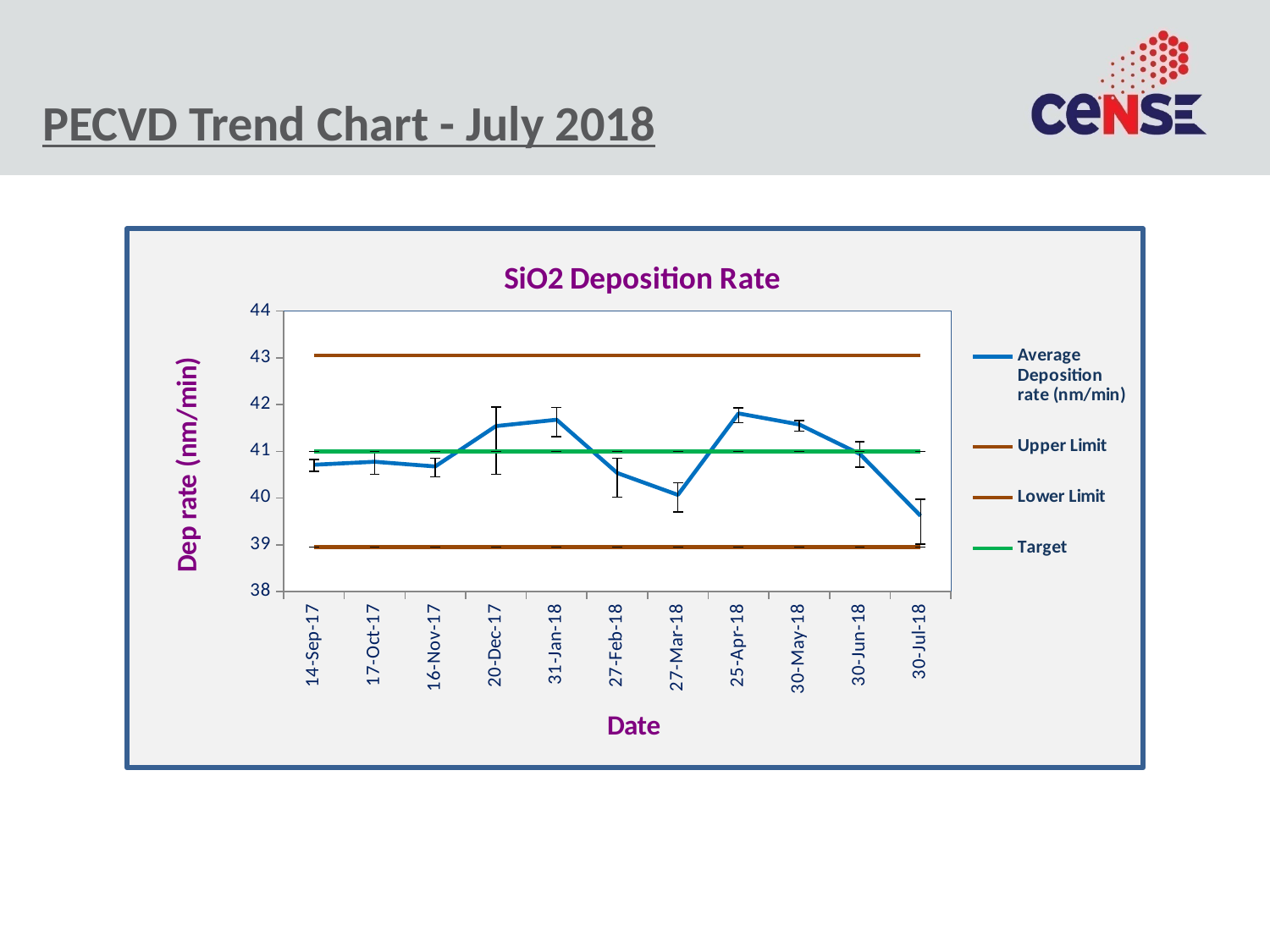
Does the Average Deposition rate rise or fall from 30-May-18 to 30-Jul-18? fall Is the Average Deposition rate for 25-Apr-18 greater or less than 41? greater What type of chart is shown on the slide? line chart Is the Average Deposition rate for 30-Jul-18 greater or less than 40? less What is the label of the y axis? Dep rate (nm/min) What is the value of the Target line? 41 Which has the larger Average Deposition rate, 25-Apr-18 or 27-Mar-18? 25-Apr-18 How many series does the legend list? 4 What is the title of the chart? SiO2 Deposition Rate How many dates are plotted along the x axis? 11 Is the Average Deposition rate for 27-Mar-18 greater or less than 41? less Which date has the lowest Average Deposition rate? 30-Jul-18